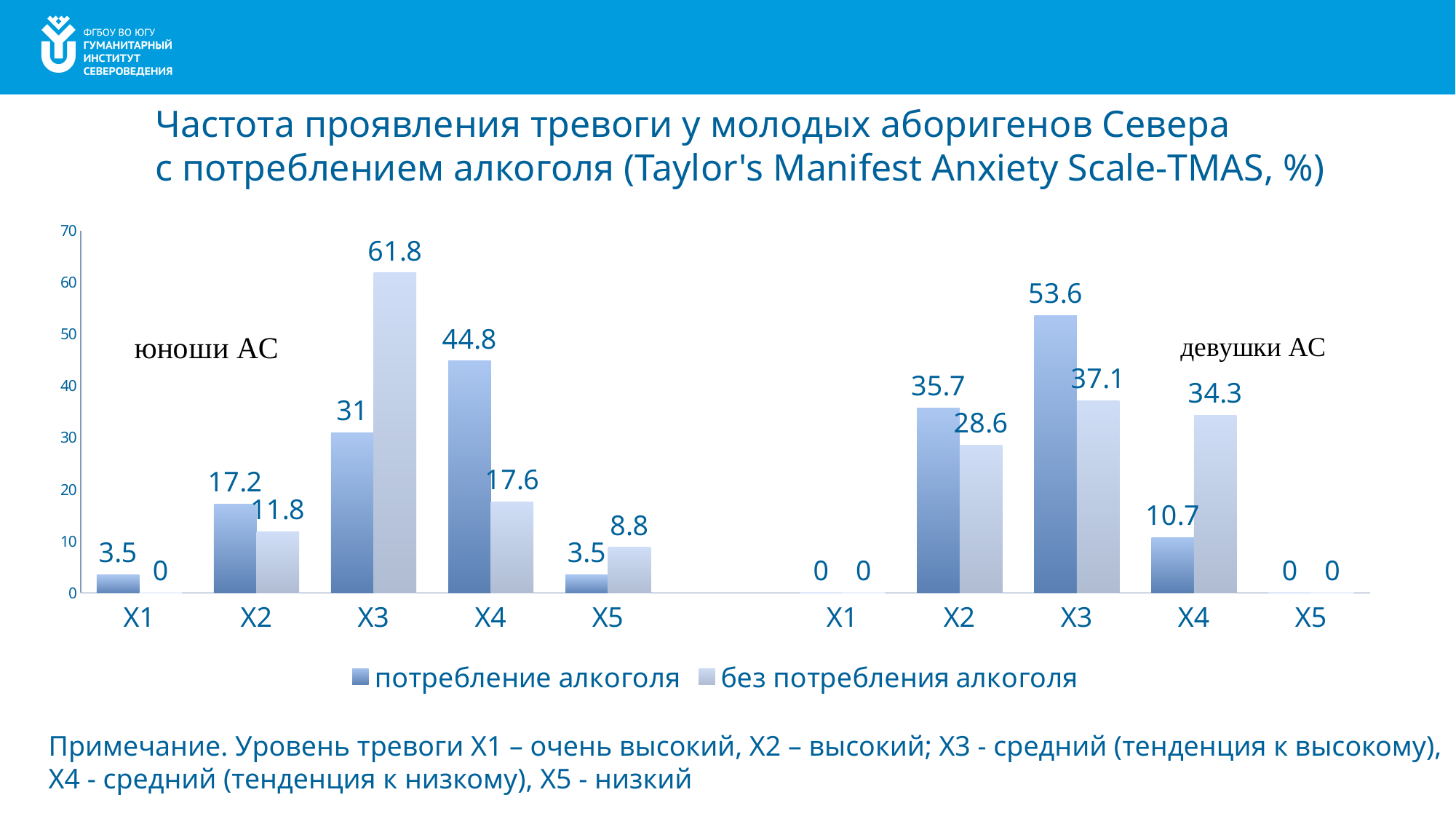
How many series does the legend list? 2 What is the value for X1 in the 'без потребления алкоголя' series for the 'юноши АС' group? 0 What is the difference between the 'без потребления алкоголя' and 'потребление алкоголя' values for X3 in the 'юноши АС' group? 30.8 Which category has the highest value in the 'без потребления алкоголя' series for the 'юноши АС' group? X3 What is the value for X2 in the 'потребление алкоголя' series for the 'девушки АС' group? 35.7 Which category has the highest value in the 'потребление алкоголя' series for the 'девушки АС' group? X3 What kind of chart is shown on the slide? bar chart For X4 in the 'девушки АС' group, which series has the larger value: 'потребление алкоголя' or 'без потребления алкоголя'? без потребления алкоголя What is the value for X3 in the 'без потребления алкоголя' series for the 'юноши АС' group? 61.8 What is the value for X4 in the 'без потребления алкоголя' series for the 'девушки АС' group? 34.3 What is the difference between the 'потребление алкоголя' and 'без потребления алкоголя' values for X3 in the 'девушки АС' group? 16.5 What is the value for X4 in the 'потребление алкоголя' series for the 'юноши АС' group? 44.8